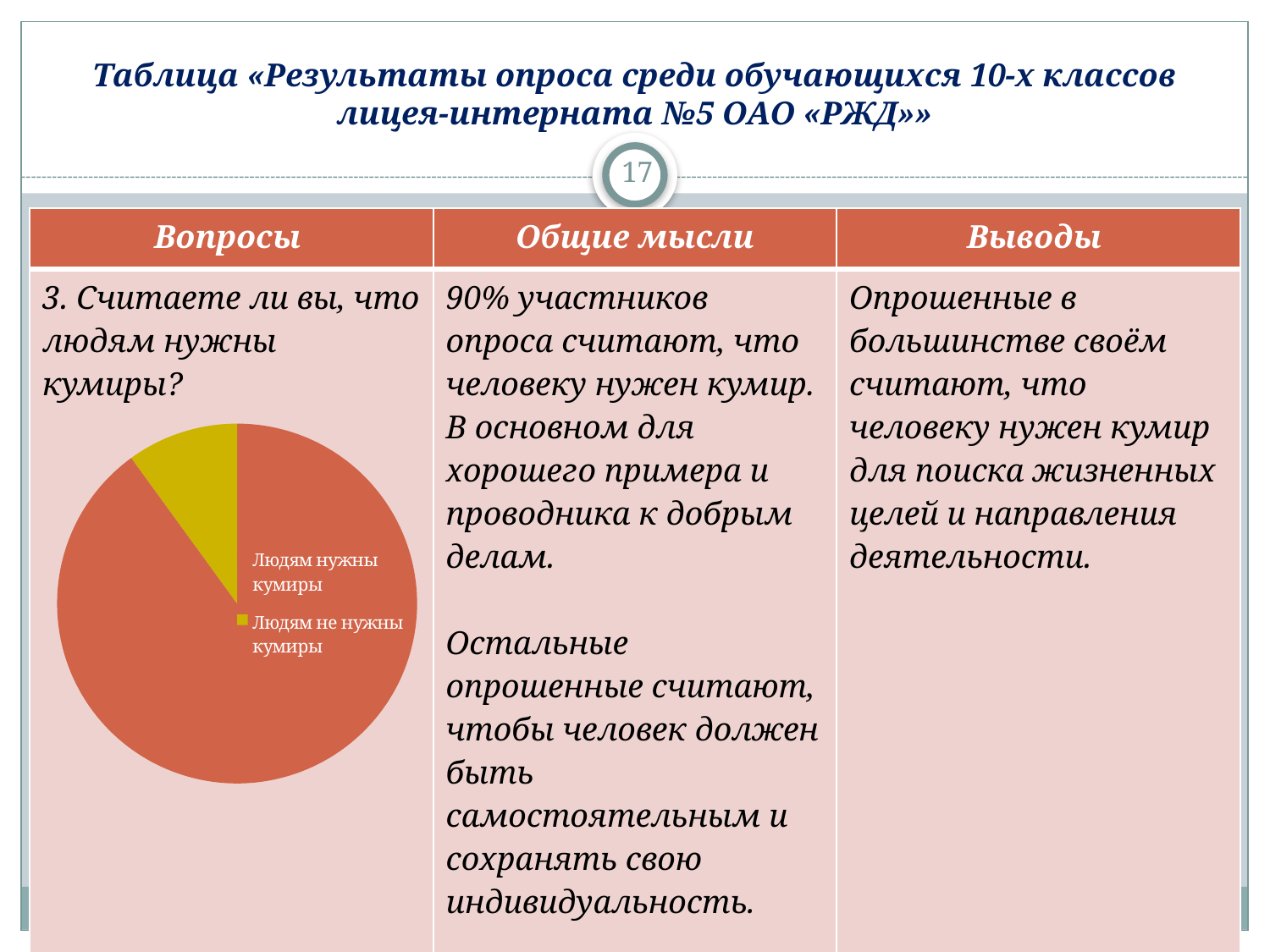
What kind of chart is shown on the slide? pie chart How many entries does the legend of the pie chart list? 2 What colour is the slice for "Людям не нужны кумиры" in the pie chart? yellow Which slice is larger: "Людям нужны кумиры" or "Людям не нужны кумиры"? Людям нужны кумиры How many slices does the pie chart have? 2 Which category has the largest slice in the pie chart? Людям нужны кумиры What colour is the slice for "Людям нужны кумиры" in the pie chart? red Which category has the smallest slice in the pie chart? Людям не нужны кумиры